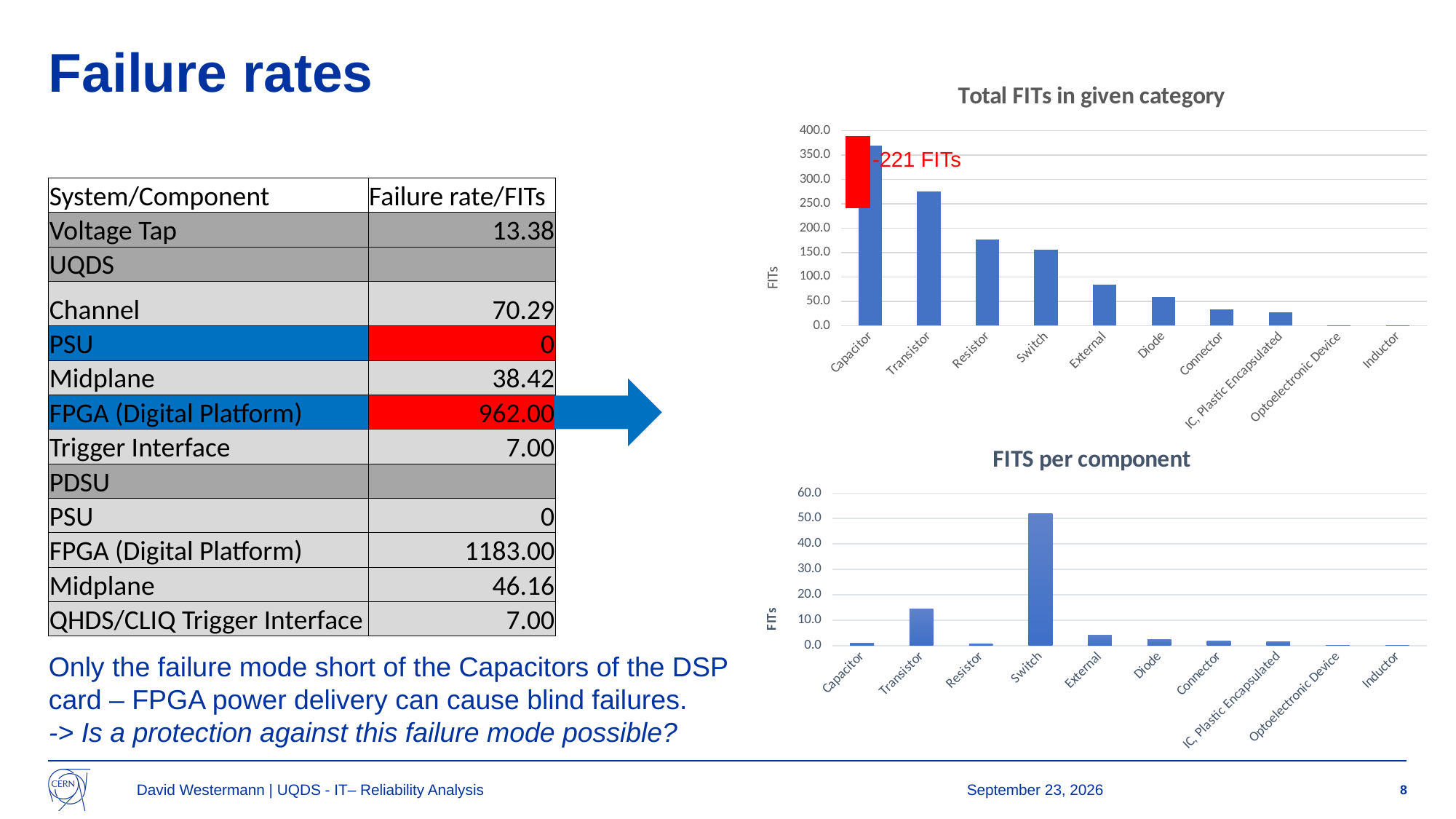
In the 'Total FITs in given category' chart, which is larger, the value for Resistor or the value for Diode? Resistor In the 'FITS per component' chart, is the value for Switch greater or less than 50.0? greater In the 'Total FITs in given category' chart, which category has the highest total FITs? Capacitor In the 'Total FITs in given category' chart, do the values rise or fall moving from left to right along the x axis? fall In the 'Total FITs in given category' chart, what kind of chart is shown? bar chart In the 'Total FITs in given category' chart, how many categories are plotted on the x axis? 10 In the 'FITS per component' chart, which component has the highest FITs per component? Switch In the 'Total FITs in given category' chart, is the value for External greater or less than 100.0? less In the 'FITS per component' chart, which is larger, the value for Transistor or the value for Capacitor? Transistor In the 'Total FITs in given category' chart, is the value for Transistor greater or less than 250.0? greater In the 'Total FITs in given category' chart, what reduction in FITs is annotated in red on the Capacitor bar? -221 FITs